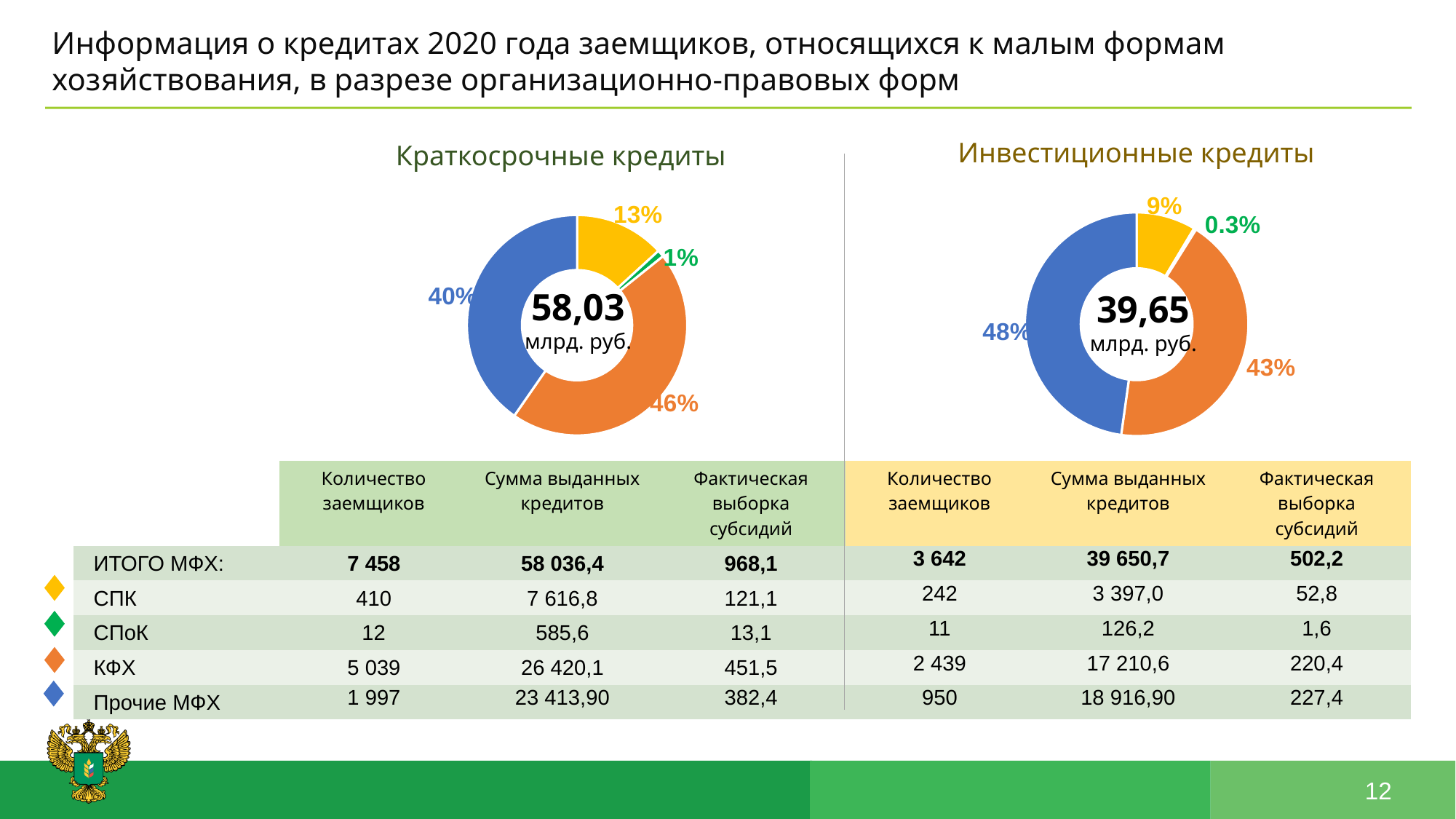
What type of chart is used for 'Инвестиционные кредиты'? Donut (pie) chart On the 'Краткосрочные кредиты' chart, what share does the КФХ slice have? 46% On the 'Инвестиционные кредиты' chart, which category has the smallest share? СПоК On the 'Инвестиционные кредиты' chart, what share does the СПоК slice have? 0.3% On the 'Краткосрочные кредиты' chart, what share does the СПК slice have? 13% How many slices does the 'Краткосрочные кредиты' chart have? 4 On the 'Краткосрочные кредиты' chart, which category has the largest share? КФХ On the 'Инвестиционные кредиты' chart, which category has the largest share? Прочие МФХ On the 'Инвестиционные кредиты' chart, what share does the Прочие МФХ slice have? 48% What total value is shown in the centre of the 'Краткосрочные кредиты' chart? 58,03 млрд. руб. On the 'Инвестиционные кредиты' chart, which is larger: the СПК share or the КФХ share? КФХ On the 'Краткосрочные кредиты' chart, what is the difference in percentage points between the КФХ share and the Прочие МФХ share? 6 percentage points